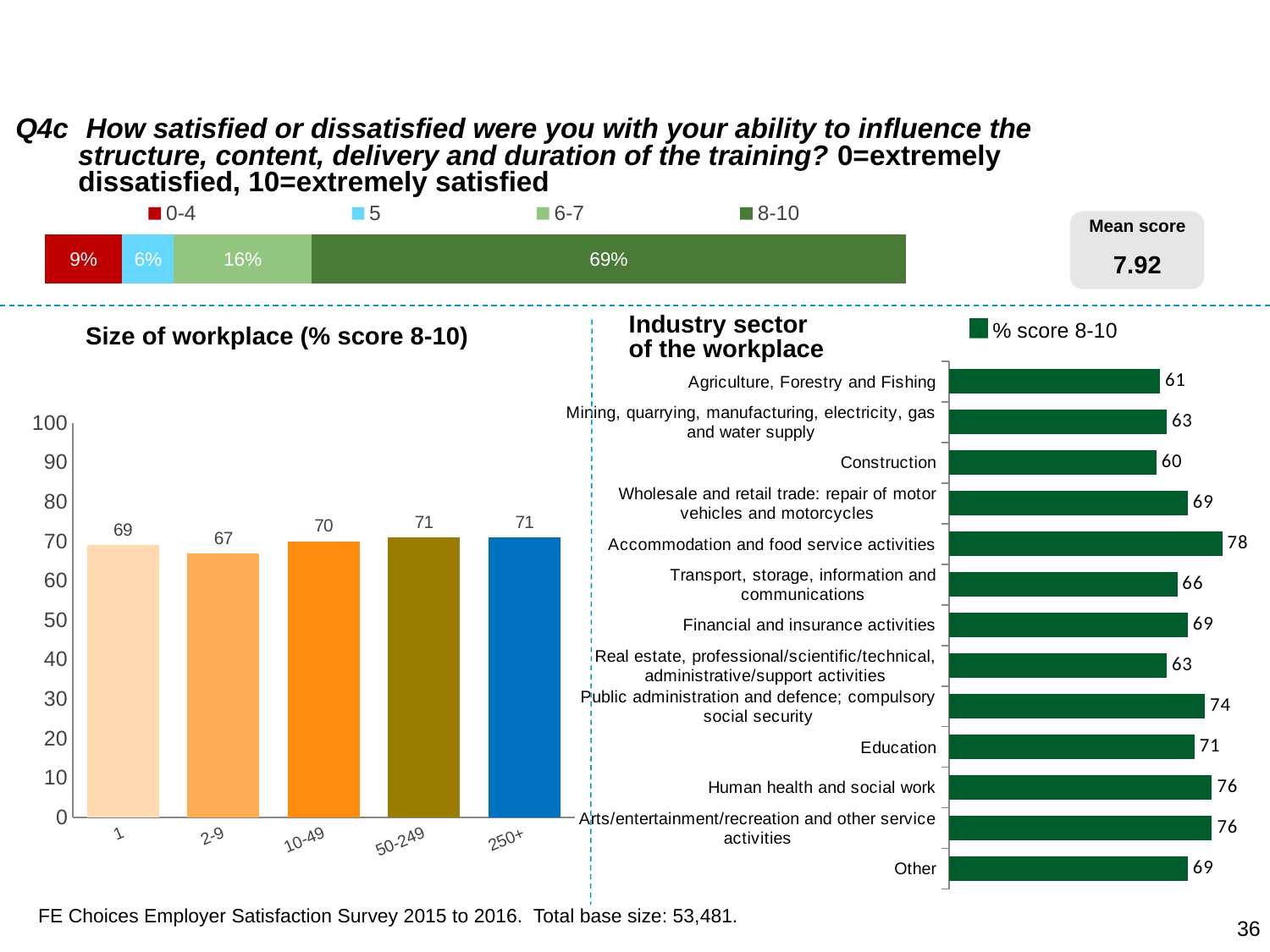
In the 'Size of workplace (% score 8-10)' chart, what is the value for the '2-9' category? 67 In the 'Industry sector of the workplace' chart, which sector has the highest % score 8-10? Accommodation and food service activities In the 'Size of workplace (% score 8-10)' chart, how many workplace size categories are shown? 5 What kind of chart is the 'Size of workplace (% score 8-10)' chart? Bar chart In the 'Industry sector of the workplace' chart, what is the difference between the values for 'Human health and social work' and 'Agriculture, Forestry and Fishing'? 15 In the 'Industry sector of the workplace' chart, which sector has the lowest % score 8-10? Construction What is the mean score shown on the slide? 7.92 In the stacked bar at the top of the slide, what percentage of respondents gave a score of 8-10? 69% In the 'Size of workplace (% score 8-10)' chart, what is the difference between the values for '250+' and '1'? 2 In the 'Size of workplace (% score 8-10)' chart, which category has the lowest value? 2-9 In the 'Industry sector of the workplace' chart, which is larger: the value for 'Education' or the value for 'Transport, storage, information and communications'? Education In the 'Industry sector of the workplace' chart, what is the value for 'Accommodation and food service activities'? 78